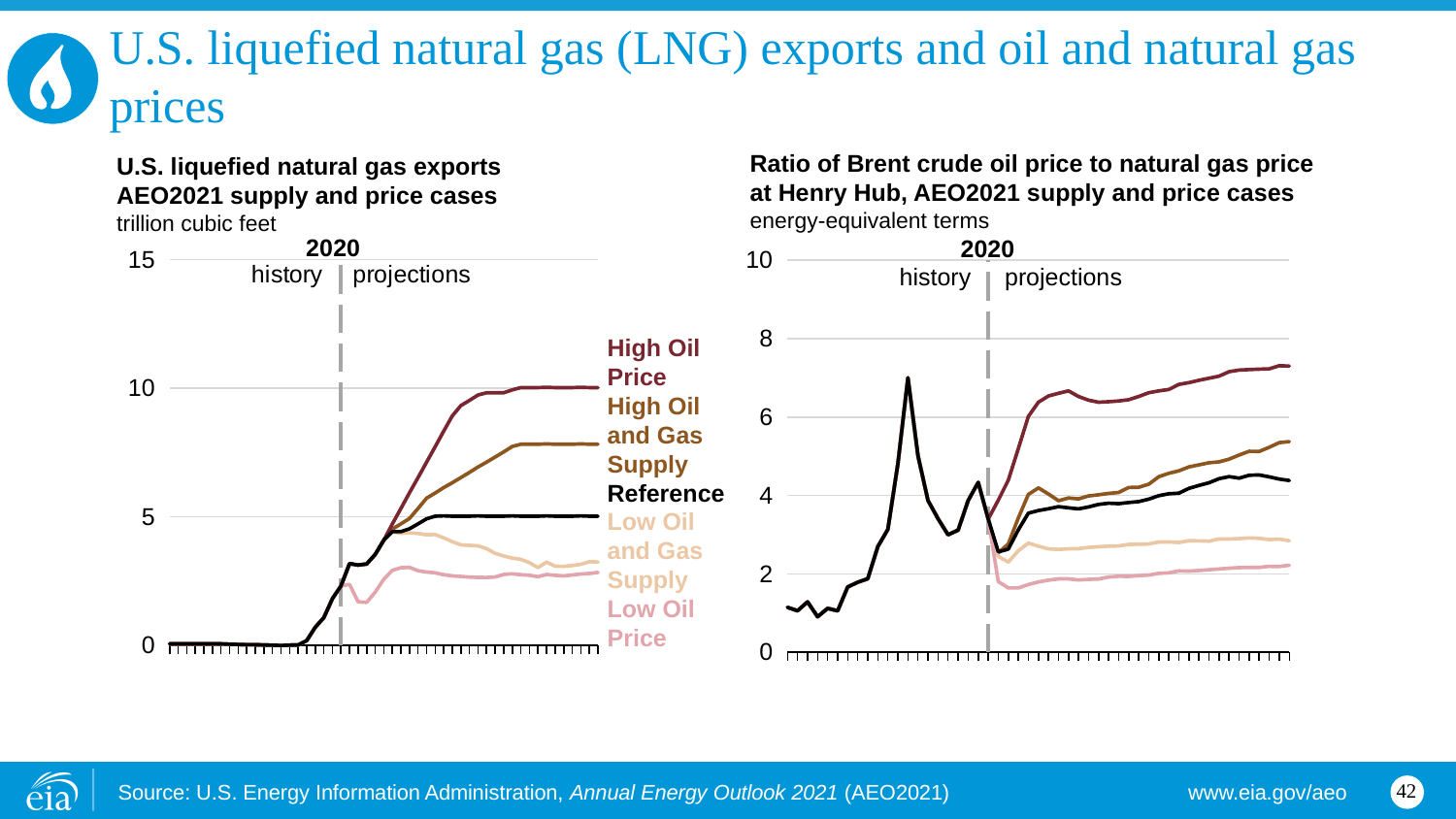
What kind of chart is the 'U.S. liquefied natural gas exports' chart on the left? line chart What unit is shown under the title of the 'U.S. liquefied natural gas exports' chart on the left? trillion cubic feet On the 'Ratio of Brent crude oil price to natural gas price at Henry Hub' chart on the right, which case has the lowest ratio at the end of the projection period? Low Oil Price How many cases (series) are labelled on the 'U.S. liquefied natural gas exports' chart on the left? 5 On the 'U.S. liquefied natural gas exports' chart on the left, does the High Oil Price case rise or fall over the projection period after 2020? rise On the 'U.S. liquefied natural gas exports' chart on the left, which case has the highest exports at the end of the projection period? High Oil Price On the 'U.S. liquefied natural gas exports' chart on the left, which case has the lowest exports at the end of the projection period? Low Oil Price On the 'U.S. liquefied natural gas exports' chart on the left, is the High Oil Price case at the end of the projection period greater or less than 5 trillion cubic feet? greater On the 'U.S. liquefied natural gas exports' chart on the left, which is larger at the end of the projection period: the High Oil and Gas Supply case or the Reference case? High Oil and Gas Supply On the 'Ratio of Brent crude oil price to natural gas price at Henry Hub' chart on the right, which case has the highest ratio at the end of the projection period? High Oil Price On the 'U.S. liquefied natural gas exports' chart on the left, is the Reference case at the end of the projection period greater or less than 10 trillion cubic feet? less On the 'Ratio of Brent crude oil price to natural gas price at Henry Hub' chart on the right, is the peak of the history line before 2020 greater or less than 6? greater